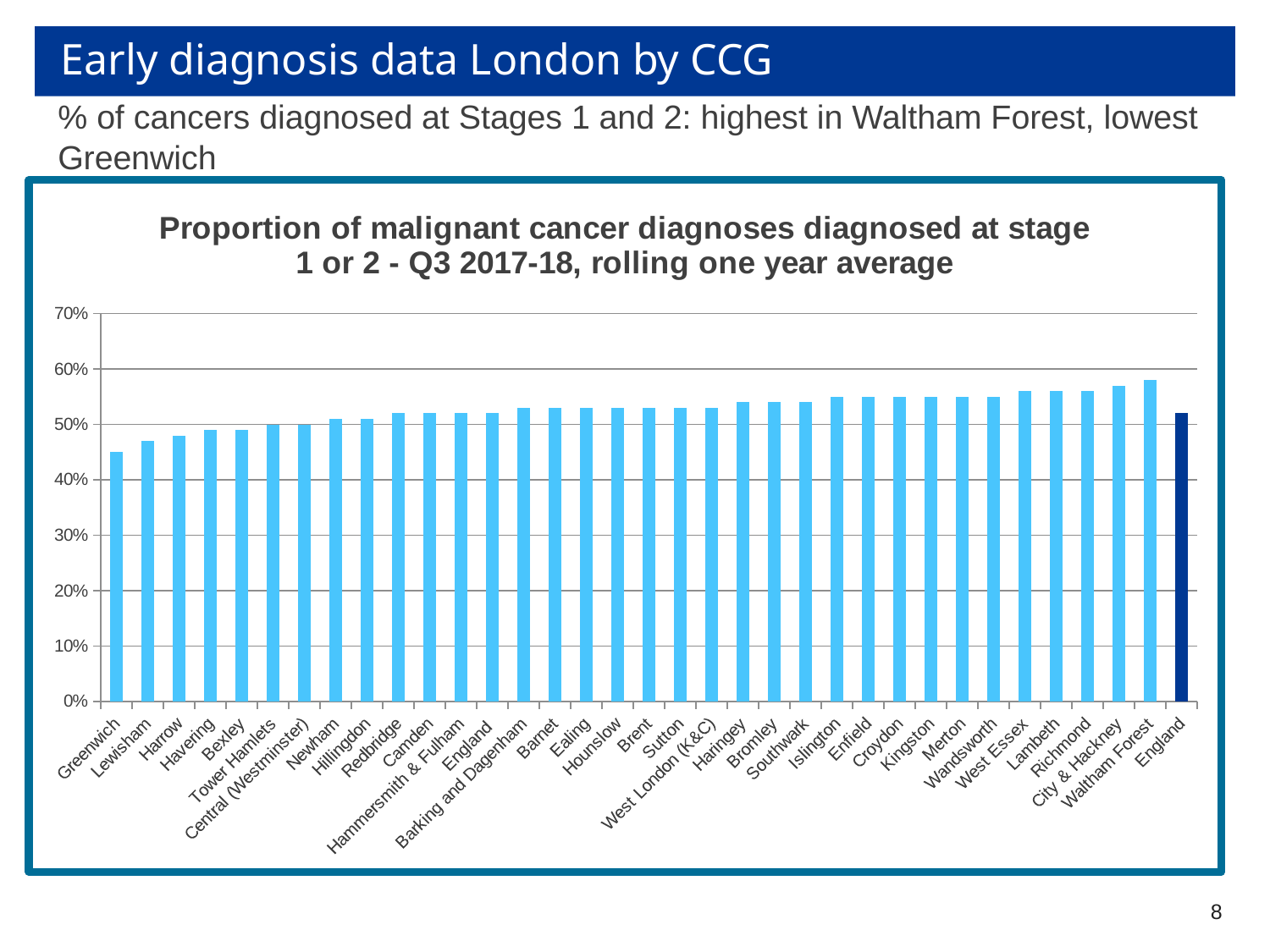
How many bars are plotted in the chart? 35 Do the values of the light blue bars generally rise or fall from left to right along the x axis? rise What is the title of the chart? Proportion of malignant cancer diagnoses diagnosed at stage 1 or 2 - Q3 2017-18, rolling one year average What kind of chart is shown on the slide? bar chart Which has a higher value, Lewisham or Richmond? Richmond Which CCG has the highest proportion of cancers diagnosed at stage 1 or 2? Waltham Forest Which has a higher value, Harrow or Lambeth? Lambeth Is the value for Greenwich greater or less than 50%? less Is the value for Greenwich greater or less than 40%? greater Is the value for Waltham Forest greater or less than 60%? less Which CCG has the lowest proportion of cancers diagnosed at stage 1 or 2? Greenwich